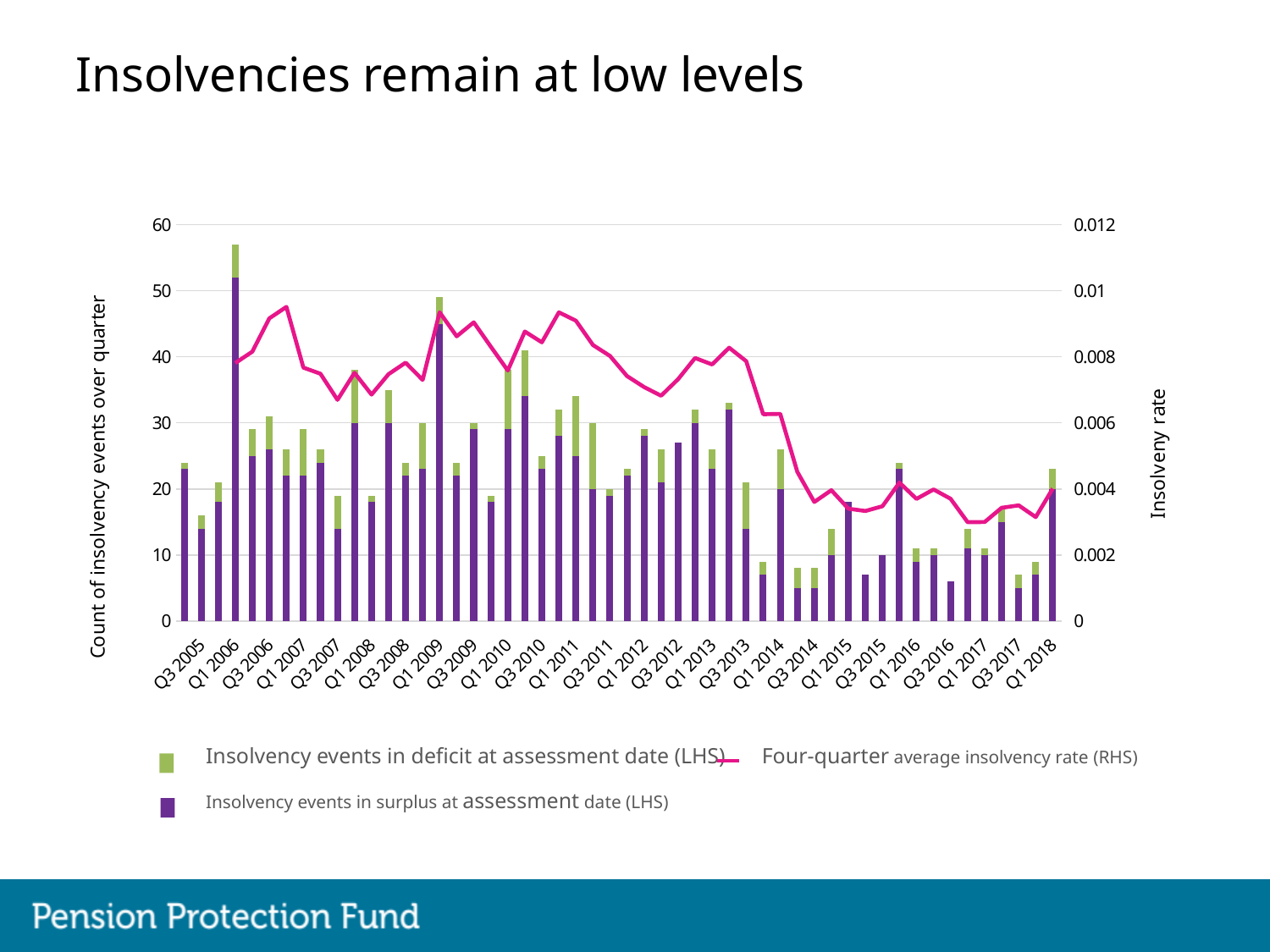
What kind of chart is shown on the slide? A combined bar and line chart (stacked bars with a line) Which quarter has the tallest stacked bar? Q1 2006 Which has the taller stacked bar, Q1 2006 or Q1 2018? Q1 2006 Does the four-quarter average insolvency rate line generally rise or fall from Q1 2013 to Q1 2018? fall Is the total stacked bar for Q1 2018 greater or less than 30? less Is the four-quarter average insolvency rate at Q1 2009 greater or less than 0.008? greater What is the label of the left vertical axis? Count of insolvency events over quarter How many series does the legend list? 3 Is the four-quarter average insolvency rate at Q1 2017 greater or less than 0.004? less What is the title of the slide? Insolvencies remain at low levels